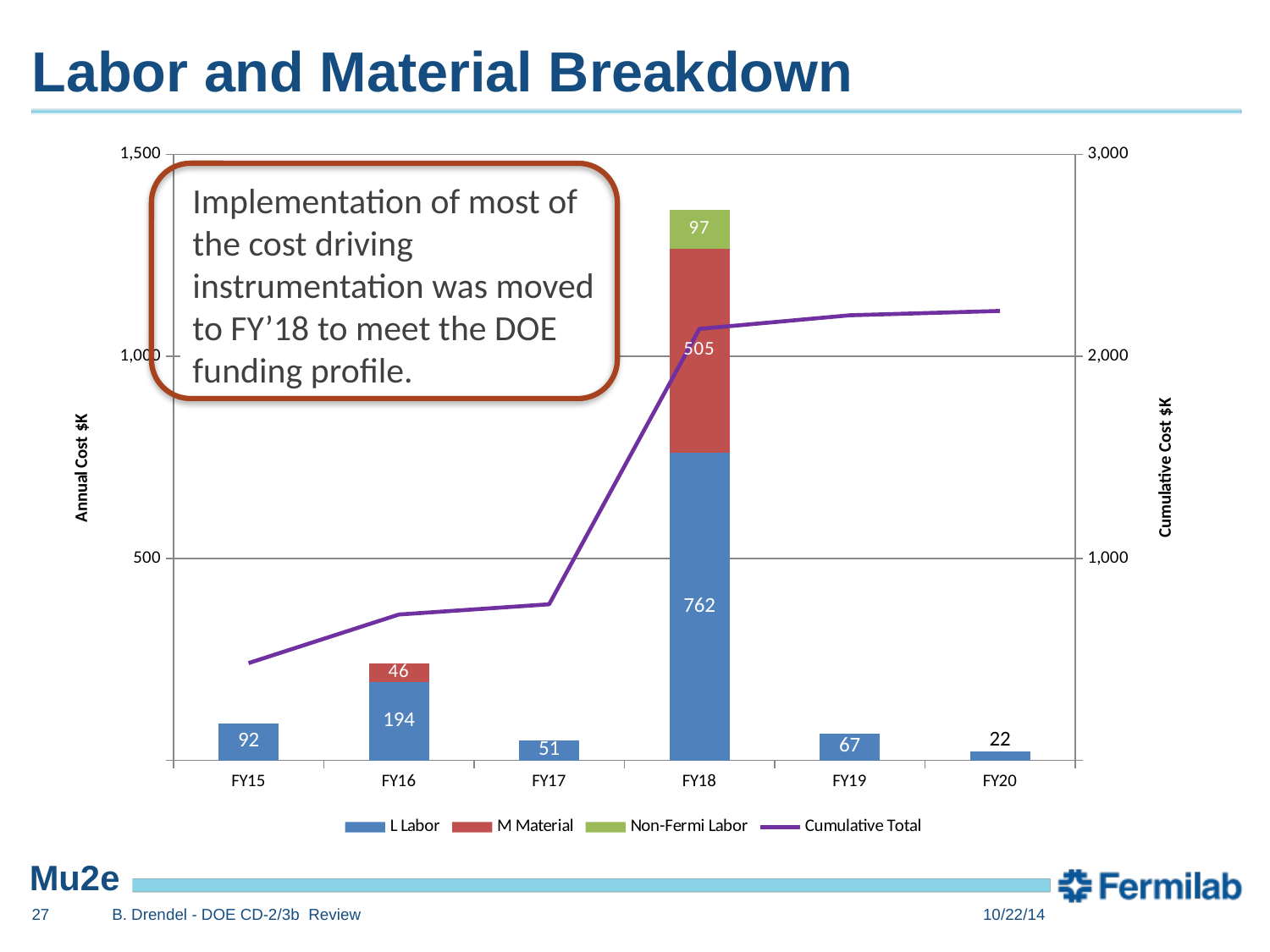
What is the total of the stacked bar for FY18? 1,364 Which fiscal year has the lowest L Labor value? FY20 Which is larger, the L Labor value for FY17 or for FY19? FY19 Which fiscal year has the highest L Labor value? FY18 What is the L Labor value for FY20? 22 Does the Cumulative Total line rise or fall from FY15 to FY20? rise Is the Cumulative Total for FY17 greater or less than 1,000? less How many series does the legend list? 4 What is the difference between the L Labor values for FY16 and FY15? 102 What is the M Material value for FY16? 46 What is the Non-Fermi Labor value for FY18? 97 What is the L Labor value for FY18? 762